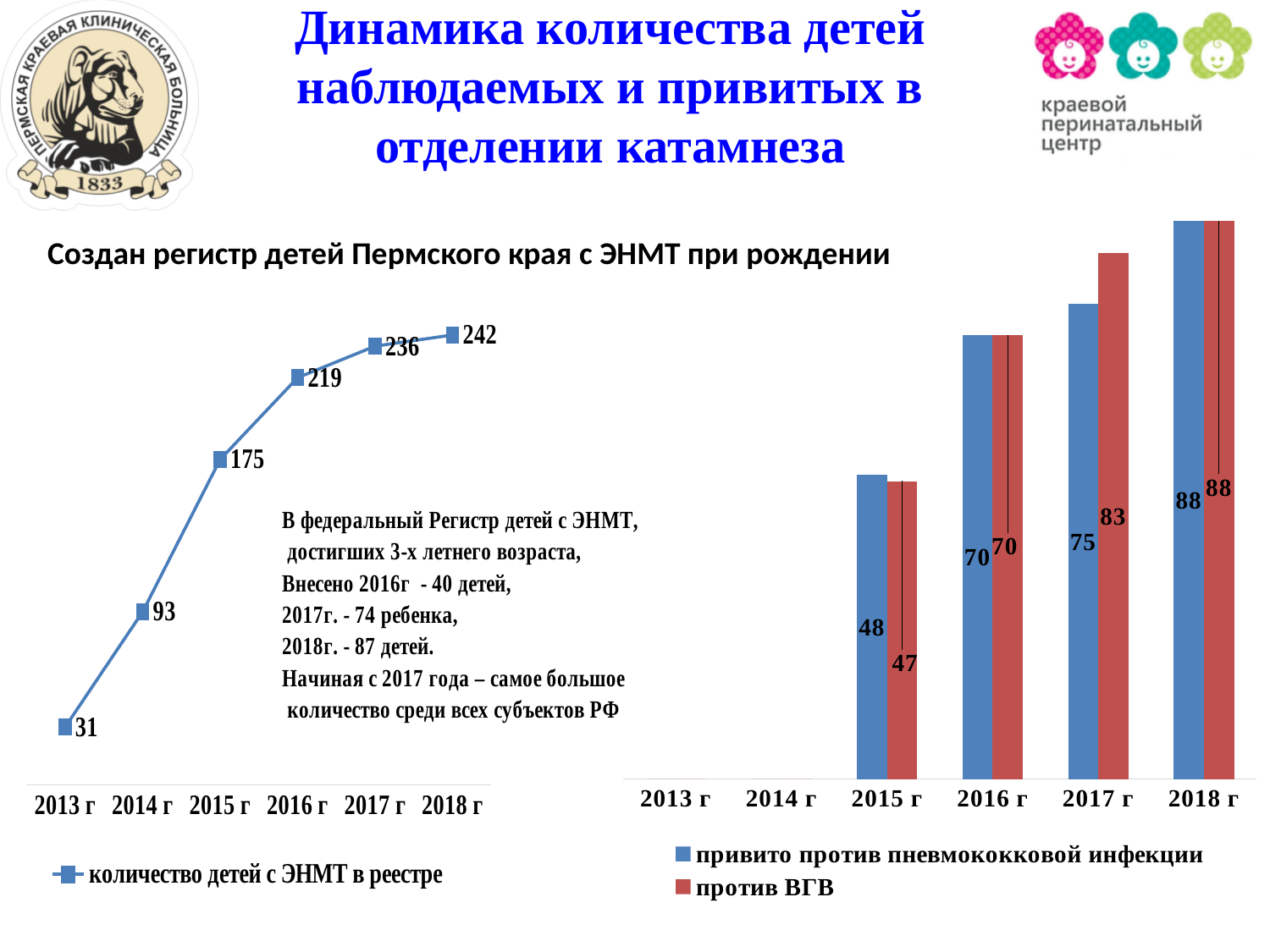
On the left line chart, do the values rise or fall from 2013 г to 2018 г? rise What kind of chart is the chart on the right of the slide? bar chart On the right bar chart, how many series does the legend list? 2 On the right bar chart, what is the difference between 'против ВГВ' in 2018 г and in 2015 г? 41 On the left line chart, which year has the lowest value? 2013 г On the left line chart, what is the difference between the values for 2014 г and 2013 г? 62 On the right bar chart, what is the value for 'привито против пневмококковой инфекции' in 2015 г? 48 On the right bar chart, which is larger in 2017 г: 'привито против пневмококковой инфекции' or 'против ВГВ'? против ВГВ On the left line chart, what is the value for 2018 г? 242 On the left line chart, what is the value for 2015 г? 175 On the left line chart, how many years are shown on the x axis? 6 On the right bar chart, what is the value for 'против ВГВ' in 2017 г? 83